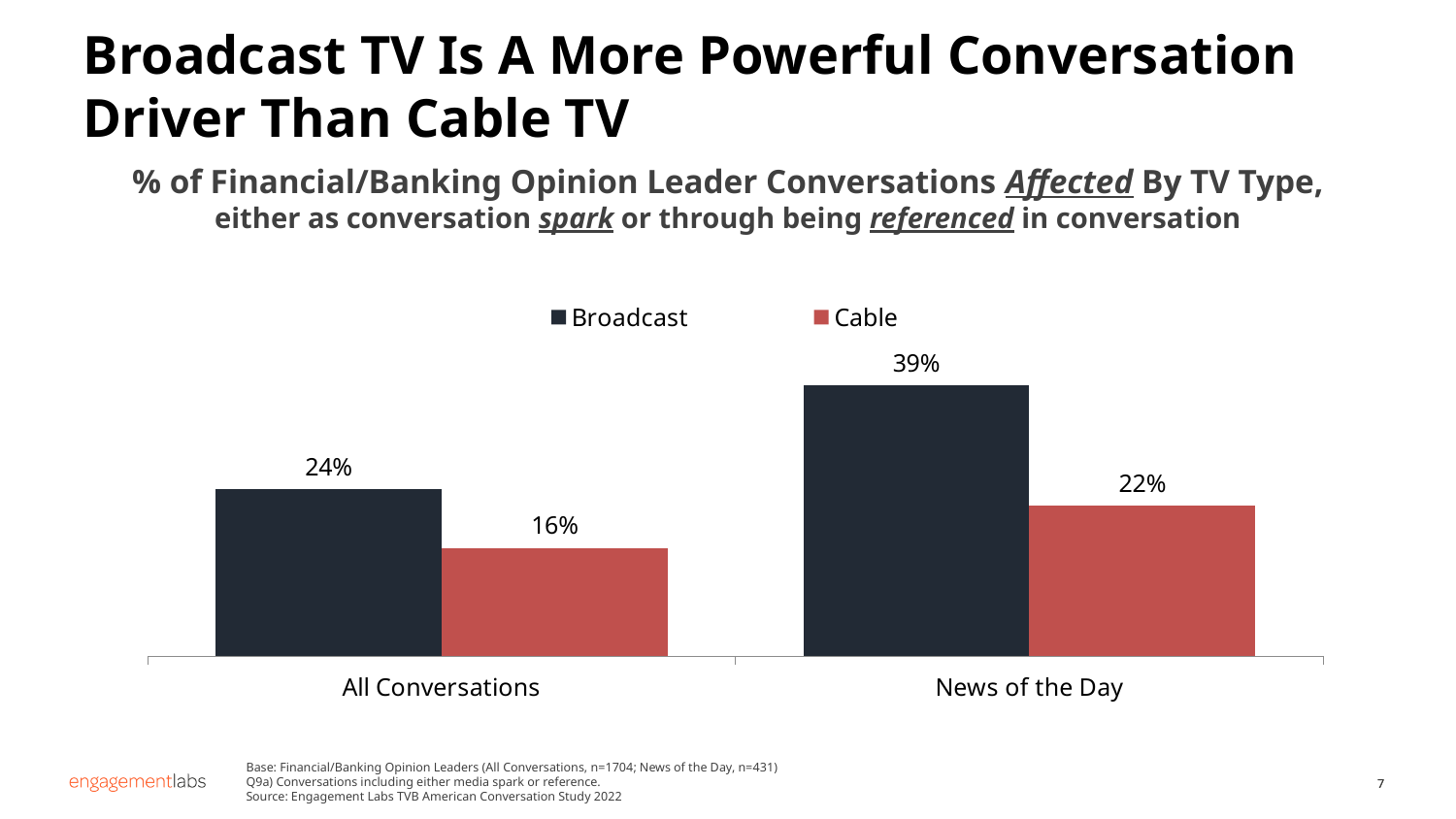
Which bar has the lowest value on the chart? Cable, All Conversations What is the difference between Broadcast and Cable in the All Conversations category? 8% Which is larger: Cable in News of the Day or Broadcast in All Conversations? Broadcast in All Conversations What kind of chart is shown on the slide? Bar chart What is the difference between Broadcast and Cable in the News of the Day category? 17% What is the value for Cable in the News of the Day category? 22% How many series does the legend list? 2 How many categories are shown on the x axis? 2 What is the value for Broadcast in the All Conversations category? 24% What is the value for Cable in the All Conversations category? 16% Which series has the highest value in the News of the Day category? Broadcast What is the value for Broadcast in the News of the Day category? 39%